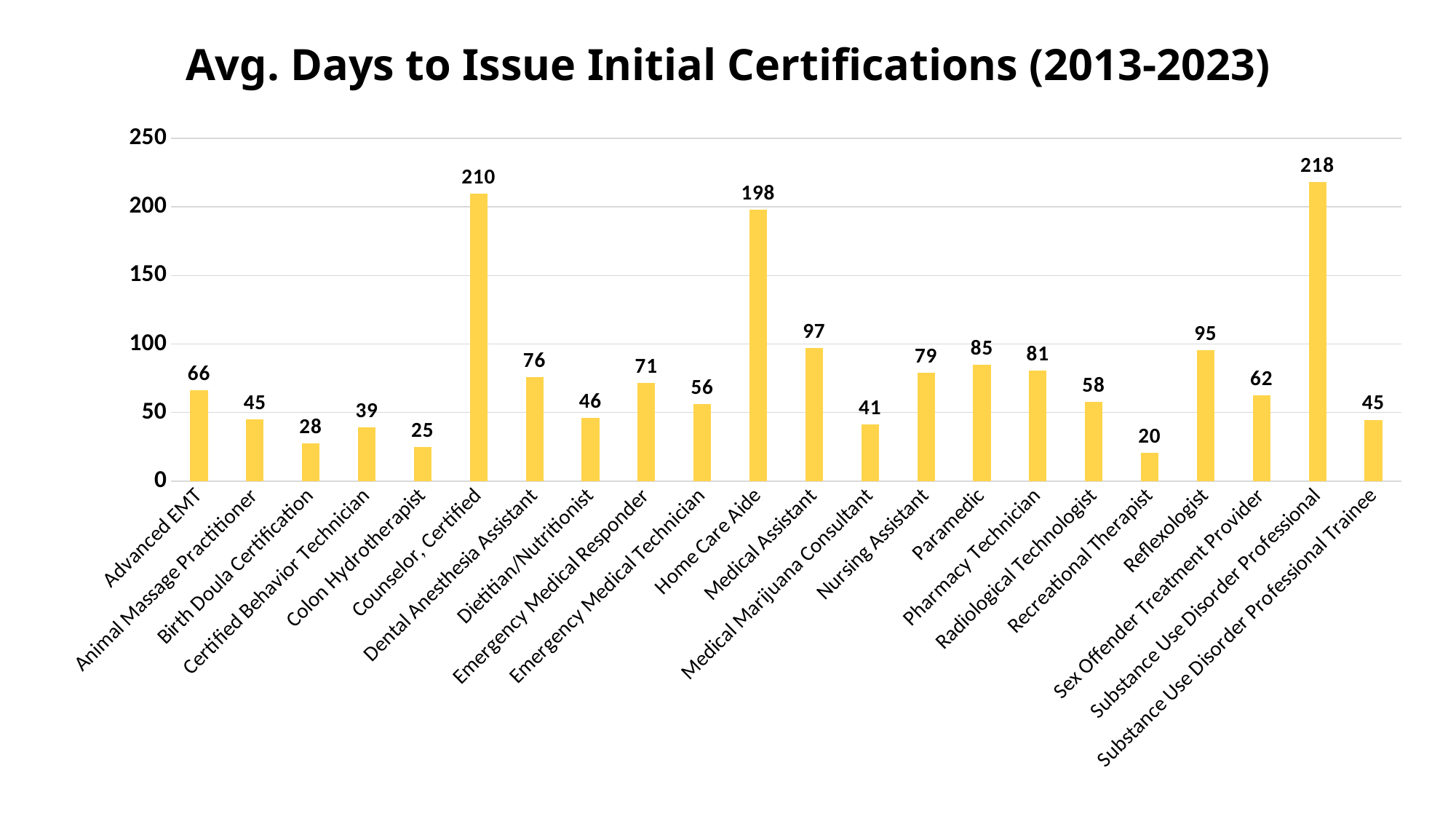
Which category has the highest average days to issue initial certifications? Substance Use Disorder Professional Which category has the lowest average days to issue initial certifications? Recreational Therapist What is the average number of days to issue initial certifications for Home Care Aide? 198 What kind of chart is shown on the slide? bar chart What is the value shown for Paramedic? 85 What is the difference between the values for Substance Use Disorder Professional and Counselor, Certified? 8 Is the value for Home Care Aide greater or less than 150? greater What is the value shown for Recreational Therapist? 20 What is the title of the chart? Avg. Days to Issue Initial Certifications (2013-2023) Which is larger, the value for Dental Anesthesia Assistant or the value for Emergency Medical Responder? Dental Anesthesia Assistant How many categories are shown on the x axis? 22 What is the difference between the values for Medical Assistant and Reflexologist? 2